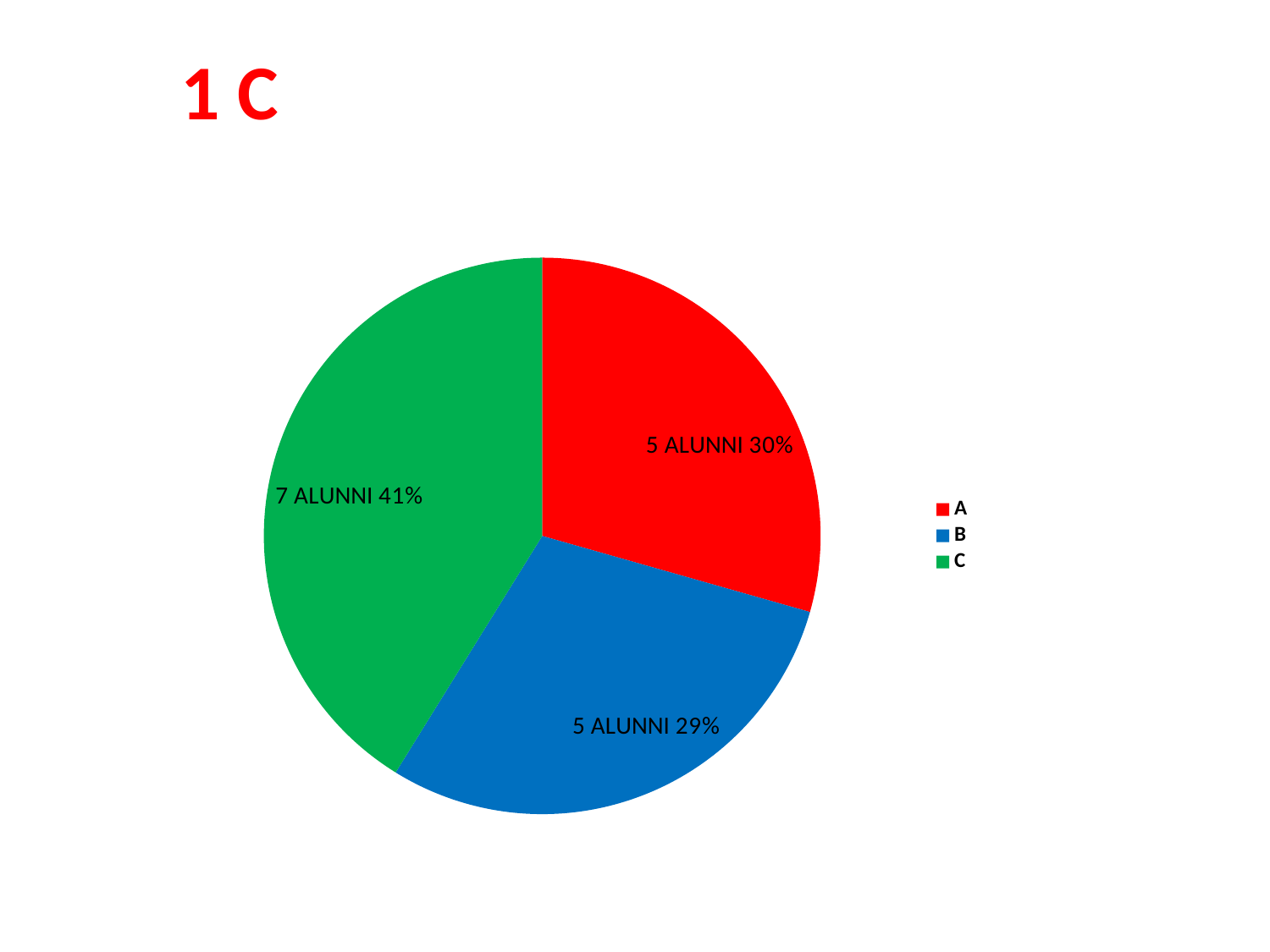
What share of the pie does slice A represent? 30% How many alunni are in slice C? 7 ALUNNI How many slices does the pie chart have? 3 Which slice is the largest in the pie chart? C What kind of chart is shown on the slide? Pie chart What share of the pie does slice C represent? 41% How many more alunni are in slice C than in slice B? 2 Which is larger, slice C or slice A? C How many alunni are in slice A? 5 ALUNNI What colour is slice C in the pie chart? Green How many entries does the legend list? 3 What share of the pie does slice B represent? 29%